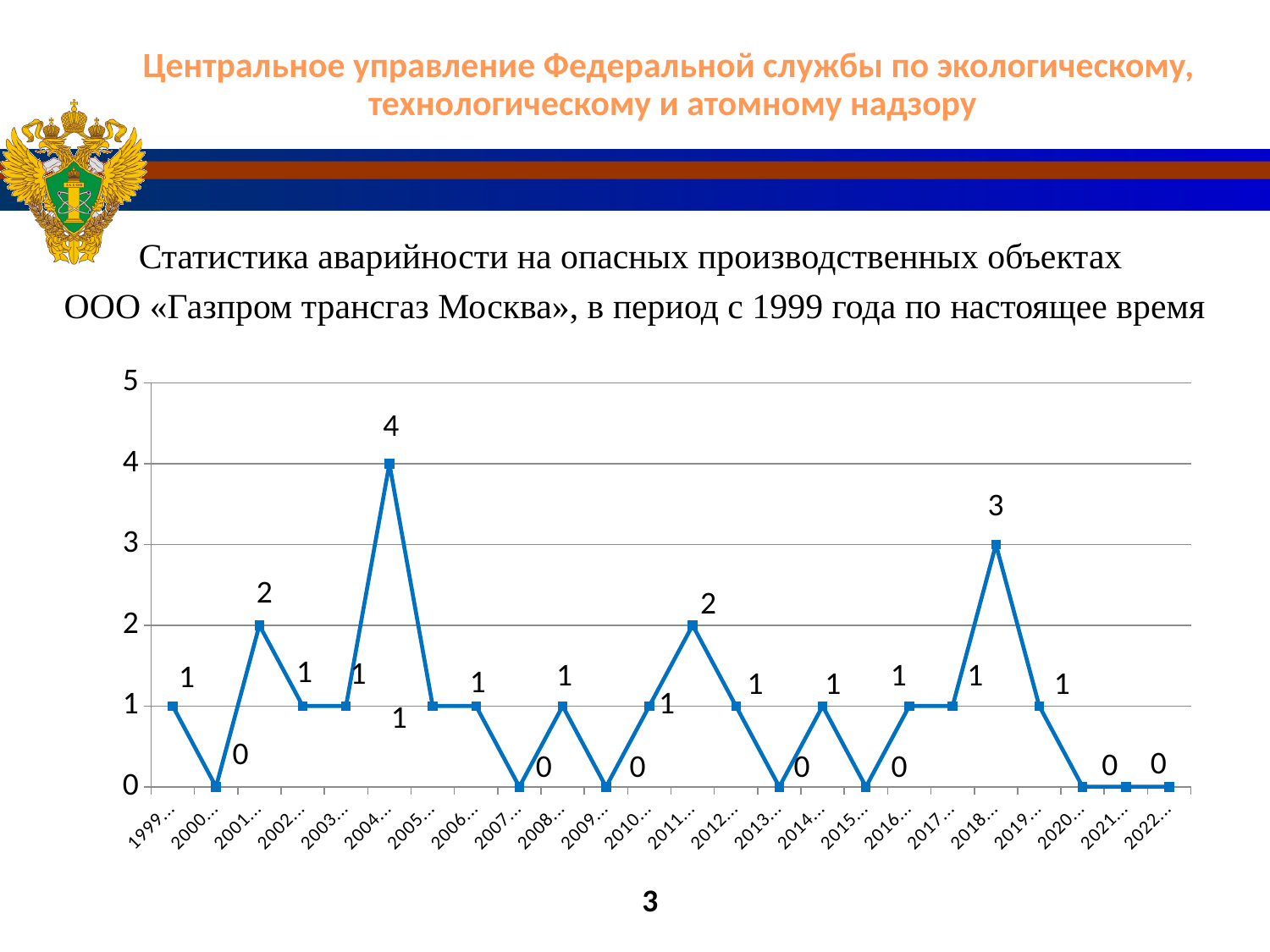
Which year has the highest value? 2004 What is the value for 2011? 2 What type of chart is shown on the slide? line chart Which is larger, the value for 2018 or the value for 2011? 2018 What is the value for 2018? 3 What is the maximum value shown on the y axis? 5 What is the difference between the values for 2004 and 2018? 1 Do the values rise or fall from 2018 to 2020? fall What is the difference between the values for 2001 and 2000? 2 How many years are plotted on the x axis? 24 What is the value for 2022? 0 What is the value for 2004? 4